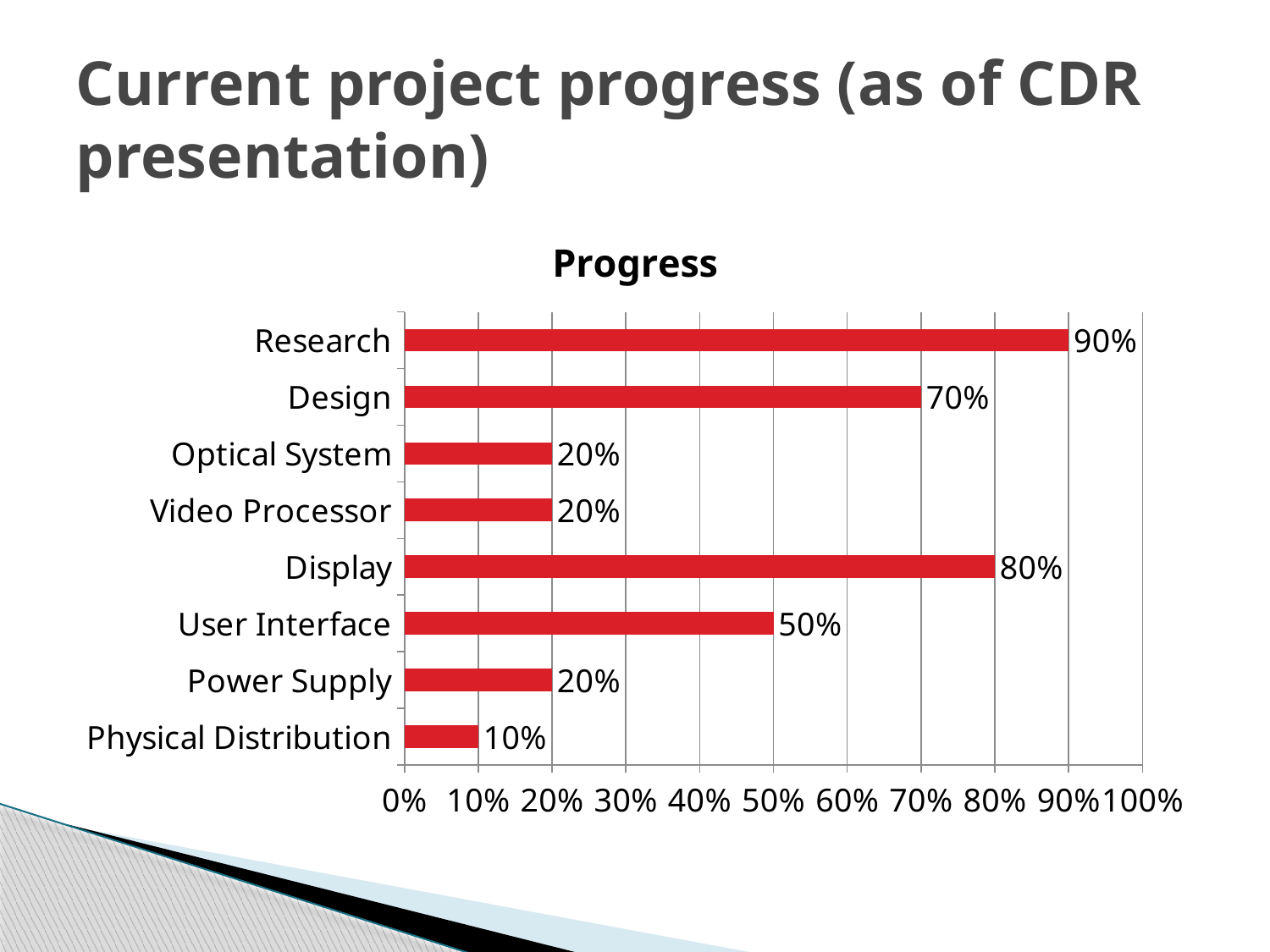
Which has a larger progress value, Design or Display? Display What is the difference between the progress values for Display and User Interface? 30% What kind of chart is shown on the slide? Bar chart Which category has the highest progress value? Research Which category has the lowest progress value? Physical Distribution What is the title of the chart? Progress Is the value for User Interface greater or less than 40%? greater What is the progress value for Research? 90% What is the progress value for User Interface? 50% How many categories are shown in the chart? 8 What is the difference between the progress values for Research and Design? 20% What is the progress value for Physical Distribution? 10%